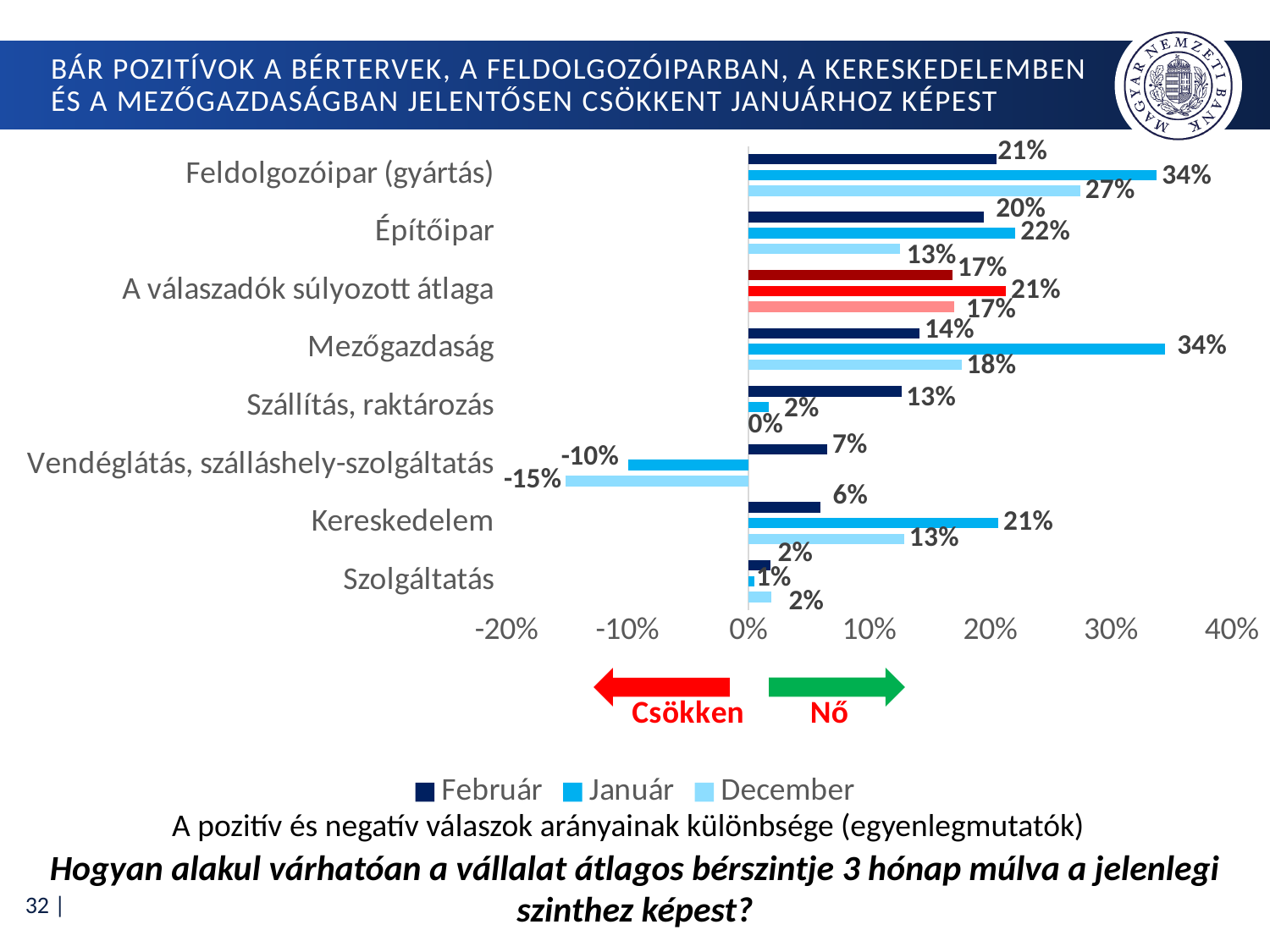
How many categories are shown on the chart? 8 What is the Február value for Feldolgozóipar (gyártás)? 21% Which category has the lowest Január value? Vendéglátás, szálláshely-szolgáltatás What kind of chart is shown on the slide? Bar chart What is the Január value for Mezőgazdaság? 34% What is the Január value for Kereskedelem? 21% Which category has the highest Február value? Feldolgozóipar (gyártás) What is the difference between the Január and Február values for Mezőgazdaság? 20 percentage points Which series is shown in the darkest blue colour? Február What is the December value for Vendéglátás, szálláshely-szolgáltatás? -15% How many series does the legend list? 3 Which is larger for Építőipar: the Január value or the December value? Január